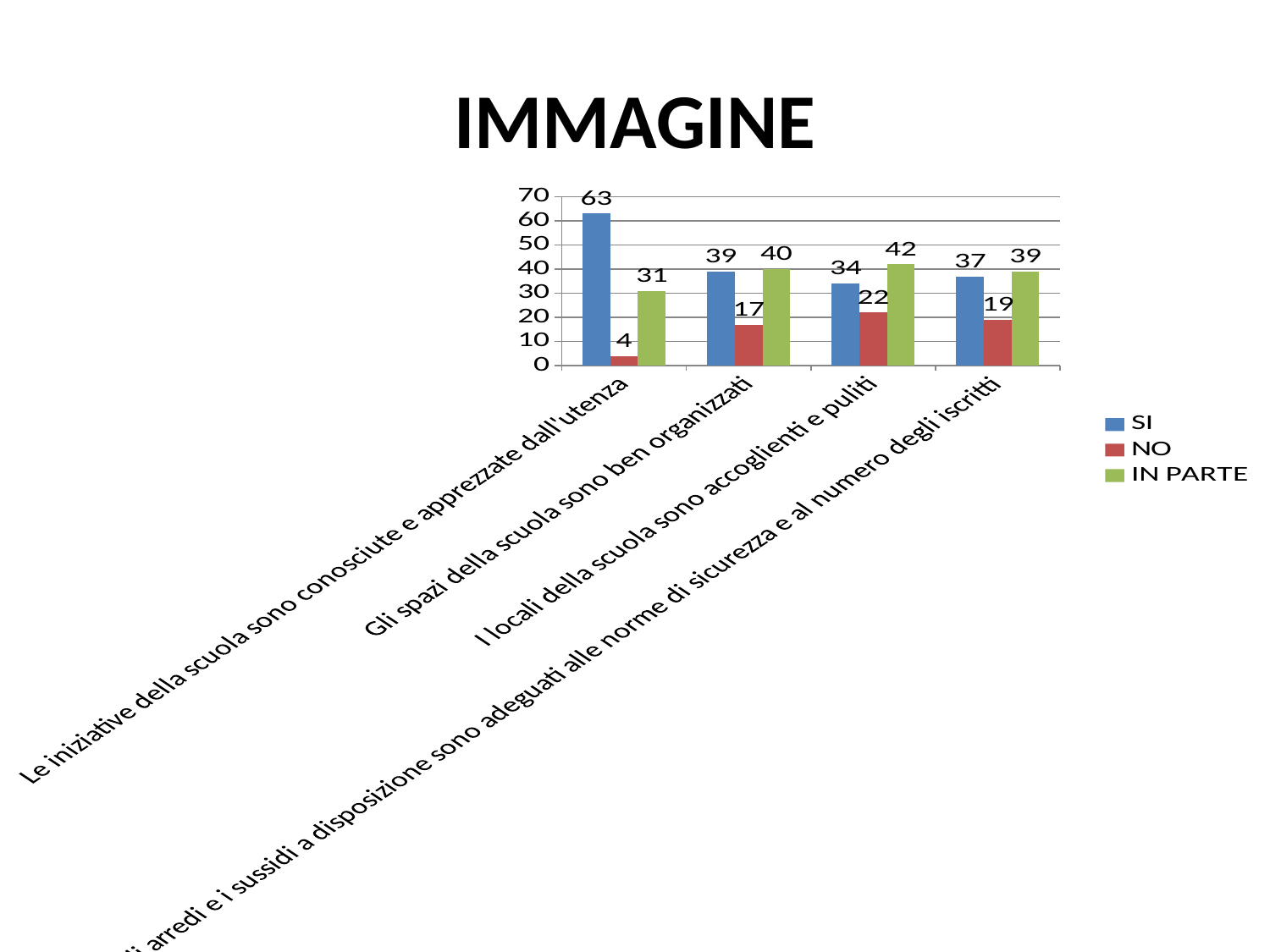
What is the SI value for "Le iniziative della scuola sono conosciute e apprezzate dall'utenza"? 63 How many categories are shown on the x axis? 4 What is the SI value for the fourth category, about arredi e sussidi adeguati alle norme di sicurezza e al numero degli iscritti? 37 Which category has the highest SI value? Le iniziative della scuola sono conosciute e apprezzate dall'utenza What kind of chart is shown on the slide? Bar chart For "Gli spazi della scuola sono ben organizzati", which is larger: SI or IN PARTE? IN PARTE What is the difference between the SI and NO values for "I locali della scuola sono accoglienti e puliti"? 12 Which category has the lowest NO value? Le iniziative della scuola sono conosciute e apprezzate dall'utenza How many series does the legend list? 3 What is the IN PARTE value for "I locali della scuola sono accoglienti e puliti"? 42 What is the title of the slide? IMMAGINE What is the NO value for "Gli spazi della scuola sono ben organizzati"? 17